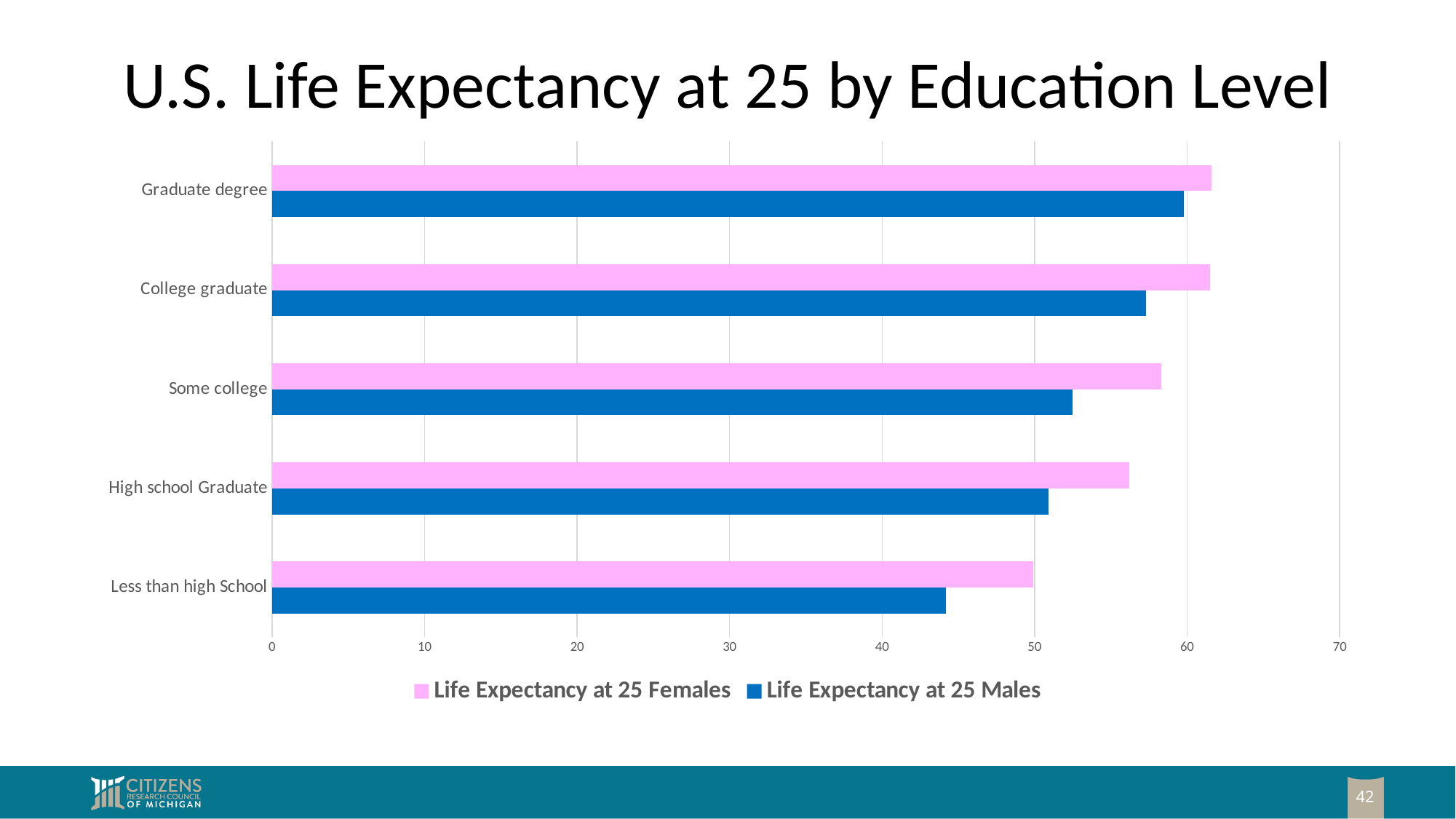
Which education level has the lowest life expectancy at 25 for males? Less than high School For each education level, which series has the longer bar, females or males? Females How many education levels are shown on the chart? 5 Is the life expectancy at 25 for males with less than high school greater or less than 50? less Is the life expectancy at 25 for females with some college greater or less than 60? less What kind of chart is shown on the slide? bar chart Which education level has the highest life expectancy at 25 for males? Graduate degree How many series does the legend list? 2 Is the life expectancy at 25 for females who are college graduates greater or less than 60? greater What colour are the bars for Life Expectancy at 25 Males? blue Which education level has the lowest life expectancy at 25 for females? Less than high School Which is larger: life expectancy at 25 for males with some college or for males with less than high school? Some college